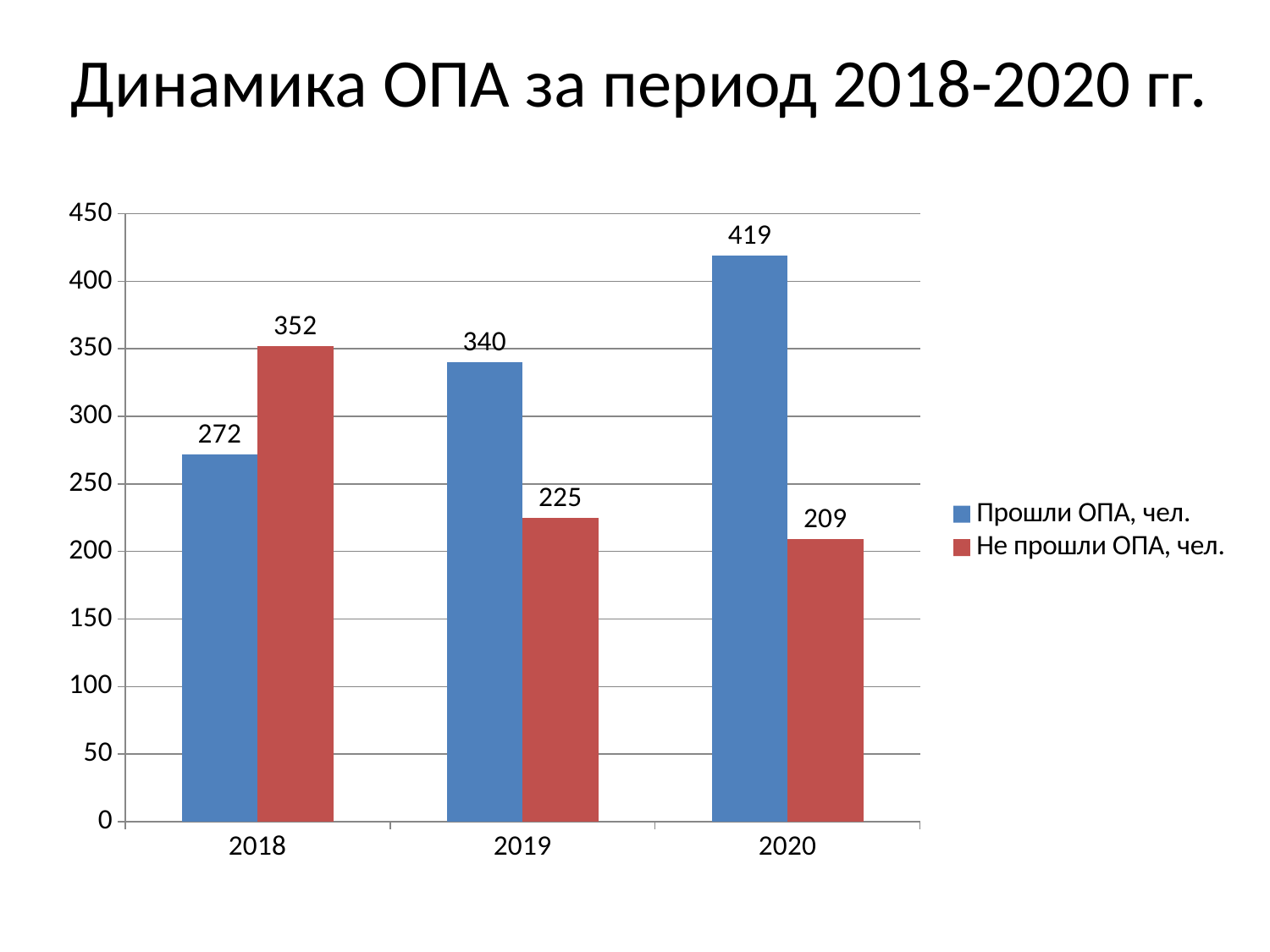
What is the value for "Не прошли ОПА, чел." in 2019? 225 How many years are shown on the x axis? 3 What is the title of the chart on the slide? Динамика ОПА за период 2018-2020 гг. Do the values for "Прошли ОПА, чел." rise or fall from 2018 to 2020? Rise In which year is the value for "Не прошли ОПА, чел." lowest? 2020 What is the value for "Прошли ОПА, чел." in 2018? 272 What kind of chart is shown on the slide? Bar chart Which is larger in 2018: "Прошли ОПА, чел." or "Не прошли ОПА, чел."? Не прошли ОПА, чел. In which year is the value for "Прошли ОПА, чел." highest? 2020 How many series does the legend list? 2 What is the value for "Не прошли ОПА, чел." in 2020? 209 What is the difference between "Прошли ОПА, чел." and "Не прошли ОПА, чел." in 2020? 210